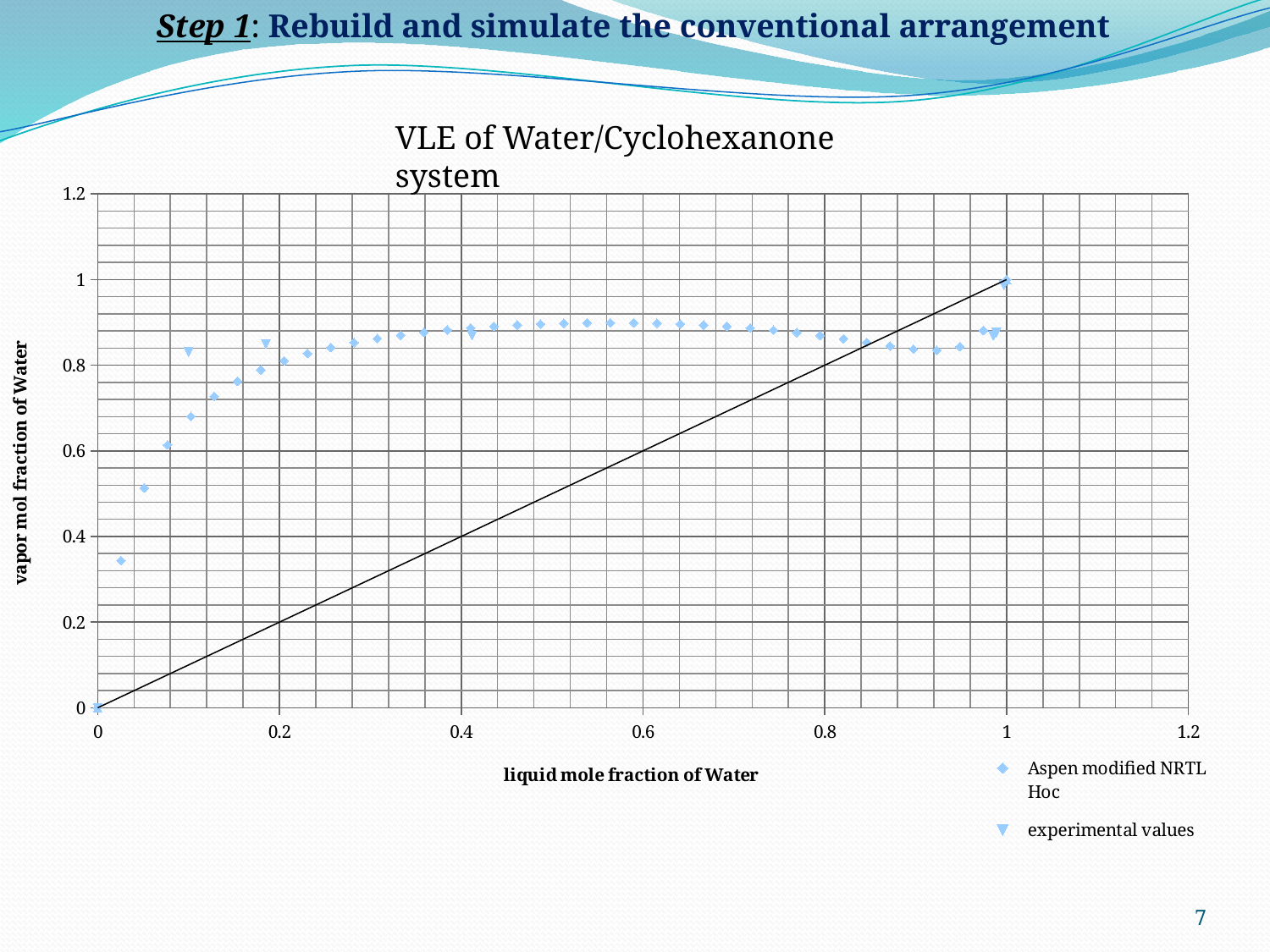
Is the Aspen modified NRTL Hoc value at a liquid mole fraction of 0.1 greater or less than 0.6? greater What is the label of the y axis? vapor mol fraction of Water What kind of chart is shown on the slide? scatter chart Is the Aspen modified NRTL Hoc value at a liquid mole fraction of 0.1 greater or less than 0.8? less Is the first Aspen modified NRTL Hoc point after the origin (near a liquid mole fraction of 0.025) greater or less than 0.4? less At which liquid mole fraction of Water does the vapor mol fraction reach its highest value? 1 Do the Aspen modified NRTL Hoc values rise or fall as the liquid mole fraction increases from 0 to 0.4? rise What is the vapor mol fraction of Water at a liquid mole fraction of 0? 0 How many series does the legend list? 2 What is the title of the chart? VLE of Water/Cyclohexanone system